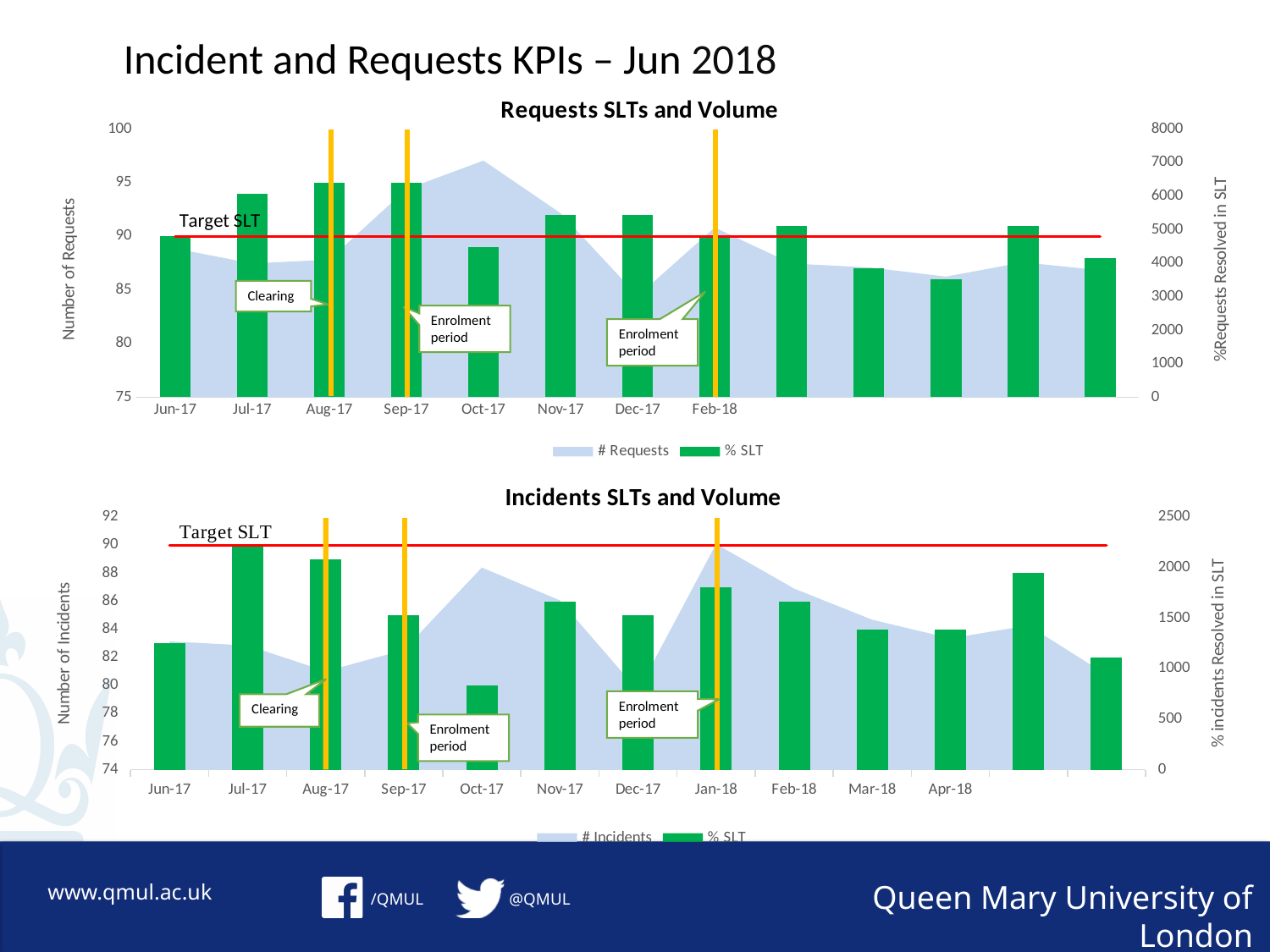
In the 'Requests SLTs and Volume' chart, which month has the larger % SLT bar, Aug-17 or Oct-17? Aug-17 In the 'Incidents SLTs and Volume' chart, is the % SLT value for Jul-17 greater or less than 88? greater In the 'Requests SLTs and Volume' chart, is the % SLT value for Oct-17 greater or less than 90? less How many series does the legend of the 'Requests SLTs and Volume' chart list? 2 In the 'Incidents SLTs and Volume' chart, which month has the lowest % SLT bar? Oct-17 In the 'Requests SLTs and Volume' chart, is the % SLT value for Jul-17 greater or less than 90? greater What kind of chart is the 'Incidents SLTs and Volume' chart? bar and area chart What value does the red Target SLT line sit at in the 'Incidents SLTs and Volume' chart? 90 What are the two legend entries in the 'Requests SLTs and Volume' chart? # Requests and % SLT In the 'Incidents SLTs and Volume' chart, which month has the larger % SLT bar, Jan-18 or Mar-18? Jan-18